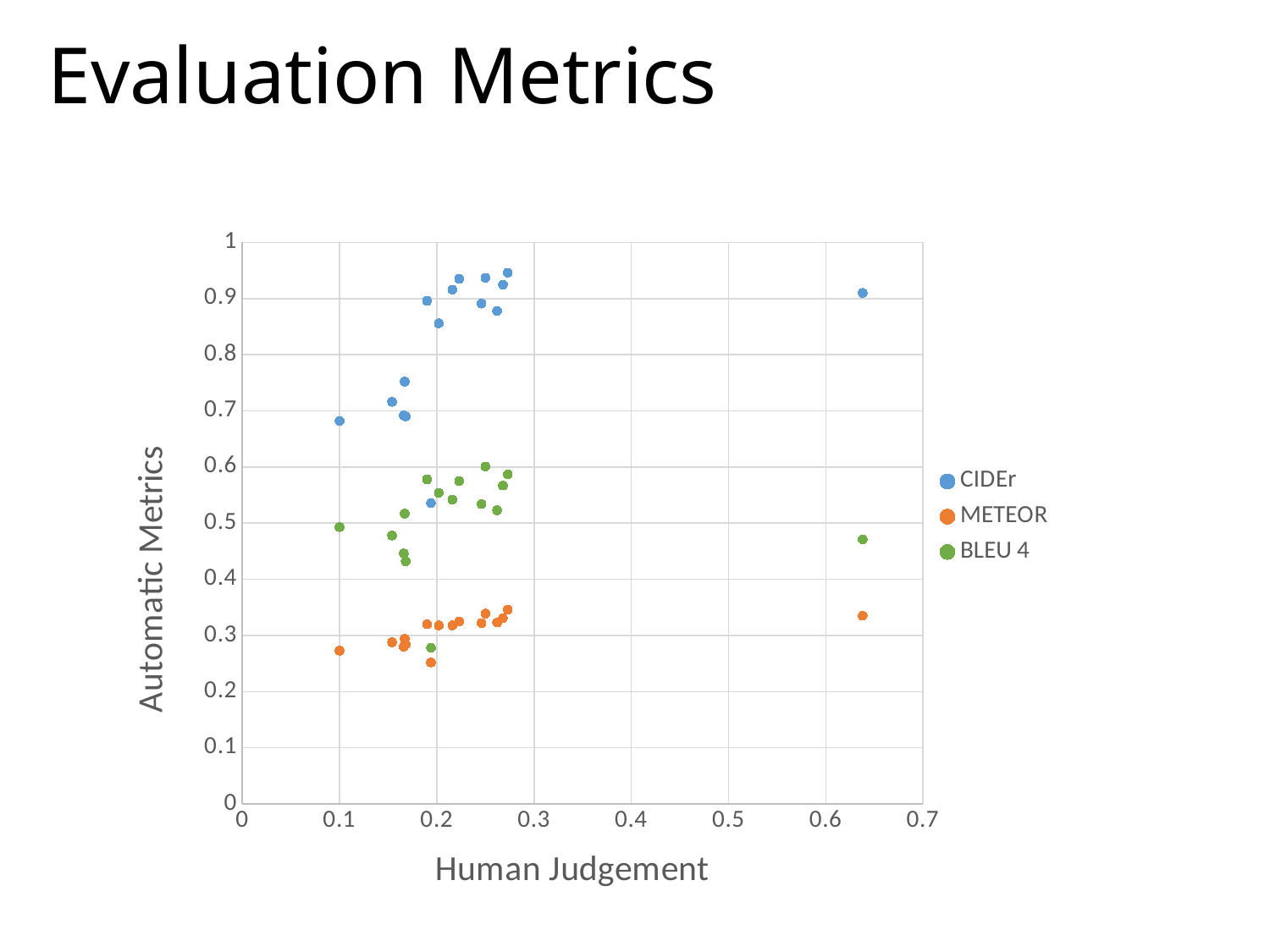
Is the CIDEr point at Human Judgement of about 0.64 greater or less than 0.8 on the Automatic Metrics axis? greater Which series has the highest Automatic Metrics values overall? CIDEr At Human Judgement of about 0.64, which series has the larger Automatic Metrics value, BLEU 4 or METEOR? BLEU 4 Is the METEOR point at Human Judgement of about 0.64 greater or less than 0.4 on the Automatic Metrics axis? less What is the label of the horizontal axis? Human Judgement What kind of chart is shown on the slide? scatter chart Is the BLEU 4 point at Human Judgement of about 0.64 greater or less than 0.6 on the Automatic Metrics axis? less What are the three series named in the legend? CIDEr, METEOR, BLEU 4 How many series does the legend list? 3 What is the maximum value shown on the Human Judgement axis? 0.7 Which series has the lowest Automatic Metrics values overall? METEOR